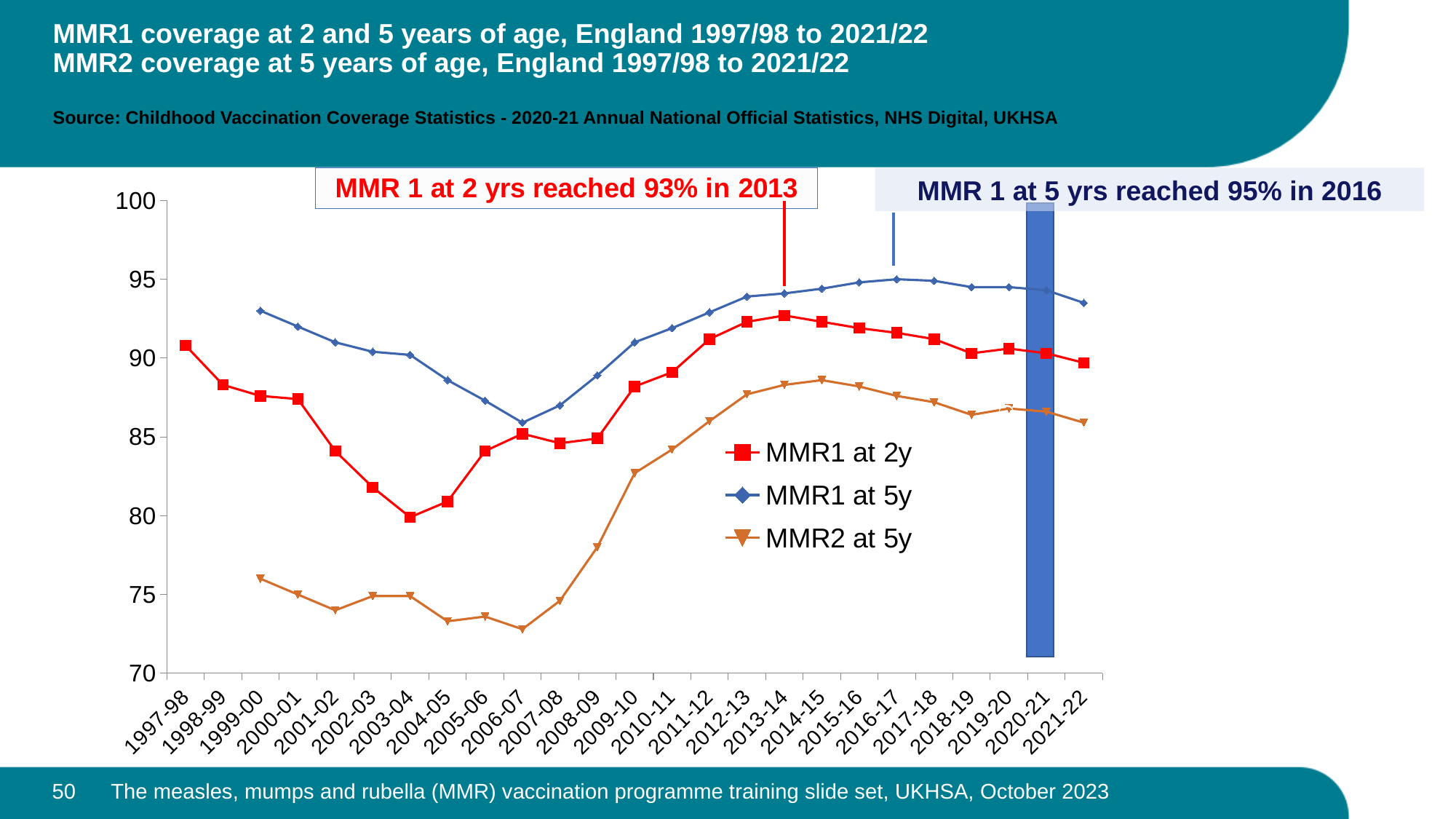
What kind of chart is shown on the slide? line chart According to the annotation, what coverage did MMR1 at 2 yrs reach in 2013? 93% How many series does the legend list? 3 According to the annotation, what coverage did MMR1 at 5 yrs reach in 2016? 95% Is the value for MMR2 at 5y in 2006-07 greater or less than 75? less Is the value for MMR2 at 5y in 1999-00 greater or less than 75? greater Does MMR2 at 5y coverage rise or fall between 2006-07 and 2014-15? rise Is the value for MMR1 at 2y in 2003-04 greater or less than 85? less How many years are shown along the x axis? 25 In which year is MMR1 at 2y coverage lowest? 2003-04 In 2021-22, which is higher: MMR1 at 5y or MMR1 at 2y? MMR1 at 5y